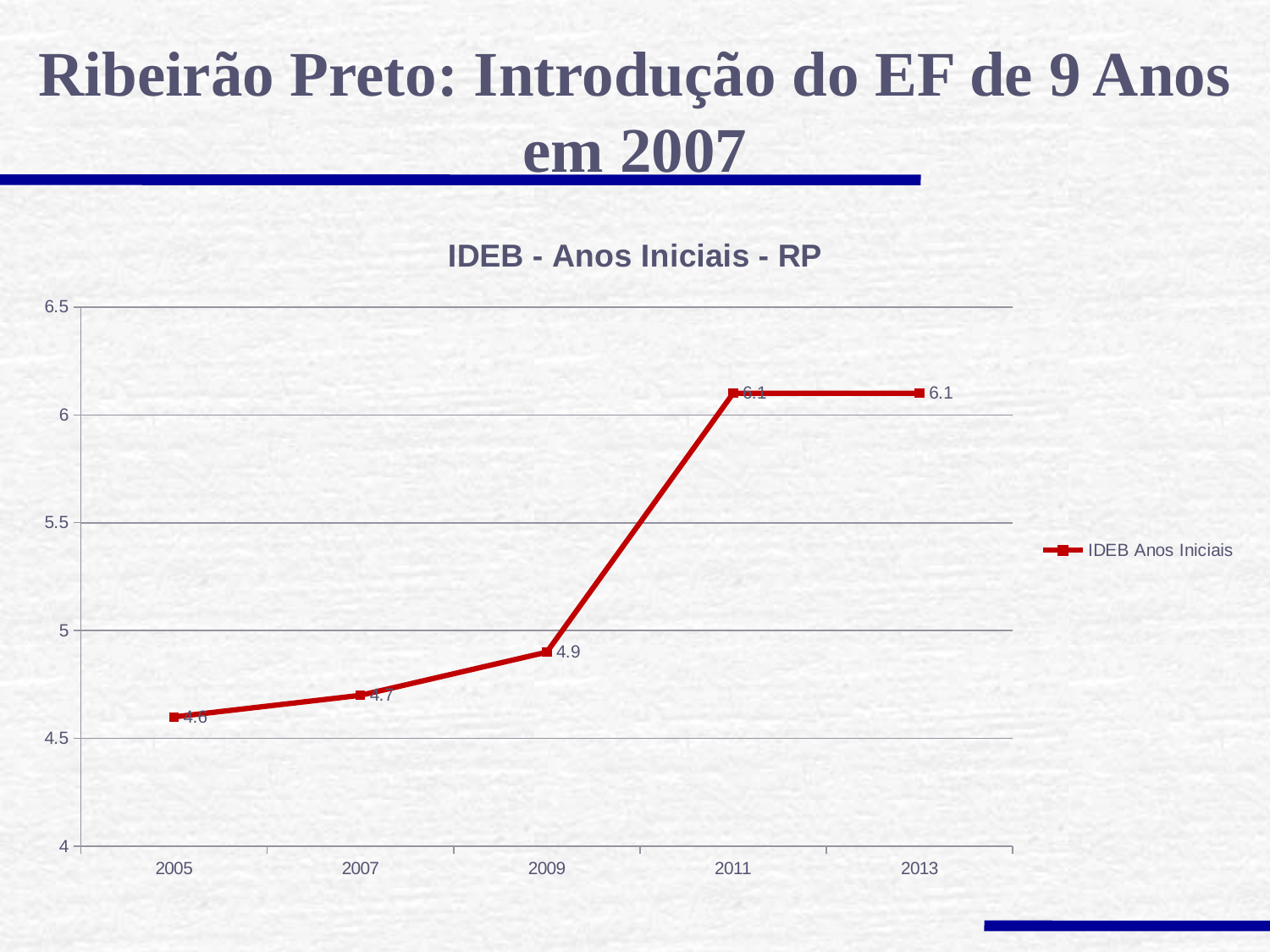
What is the title of the chart? IDEB - Anos Iniciais - RP Do the IDEB Anos Iniciais values rise or fall from 2005 to 2011? rise What is the IDEB Anos Iniciais value for 2011? 6.1 What type of chart is shown on the slide? line chart What is the IDEB Anos Iniciais value for 2013? 6.1 What is the difference between the IDEB Anos Iniciais values for 2011 and 2009? 1.2 What is the IDEB Anos Iniciais value for 2009? 4.9 Which year has a larger IDEB Anos Iniciais value, 2009 or 2011? 2011 Which year has the lowest IDEB Anos Iniciais value? 2005 How many years are plotted on the x axis? 5 What is the highest IDEB Anos Iniciais value shown in the chart? 6.1 What is the IDEB Anos Iniciais value for 2007? 4.7